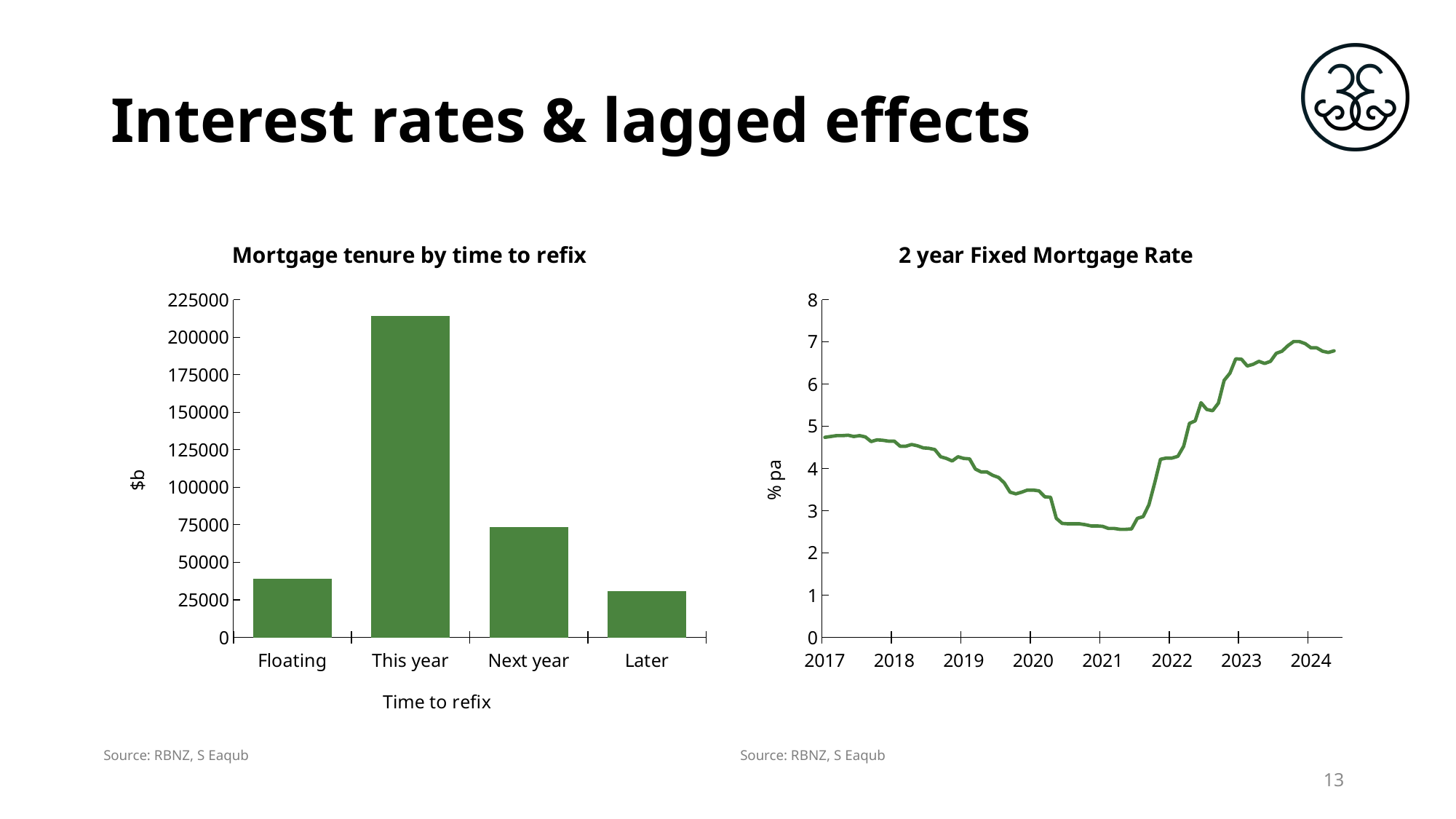
In 'Mortgage tenure by time to refix', is the value for This year greater or less than 200000? greater What kind of chart is '2 year Fixed Mortgage Rate'? line chart In '2 year Fixed Mortgage Rate', is the rate at the start of 2021 greater or less than 3? less In 'Mortgage tenure by time to refix', is the value for Floating greater or less than 50000? less In 'Mortgage tenure by time to refix', which time to refix category has the highest value? This year What kind of chart is 'Mortgage tenure by time to refix'? bar chart What is the y-axis label of 'Mortgage tenure by time to refix'? $b In 'Mortgage tenure by time to refix', which time to refix category has the lowest value? Later In 'Mortgage tenure by time to refix', which is larger: Floating or Next year? Next year In '2 year Fixed Mortgage Rate', does the rate rise or fall between 2021 and 2023? rise How many categories are shown in 'Mortgage tenure by time to refix'? 4